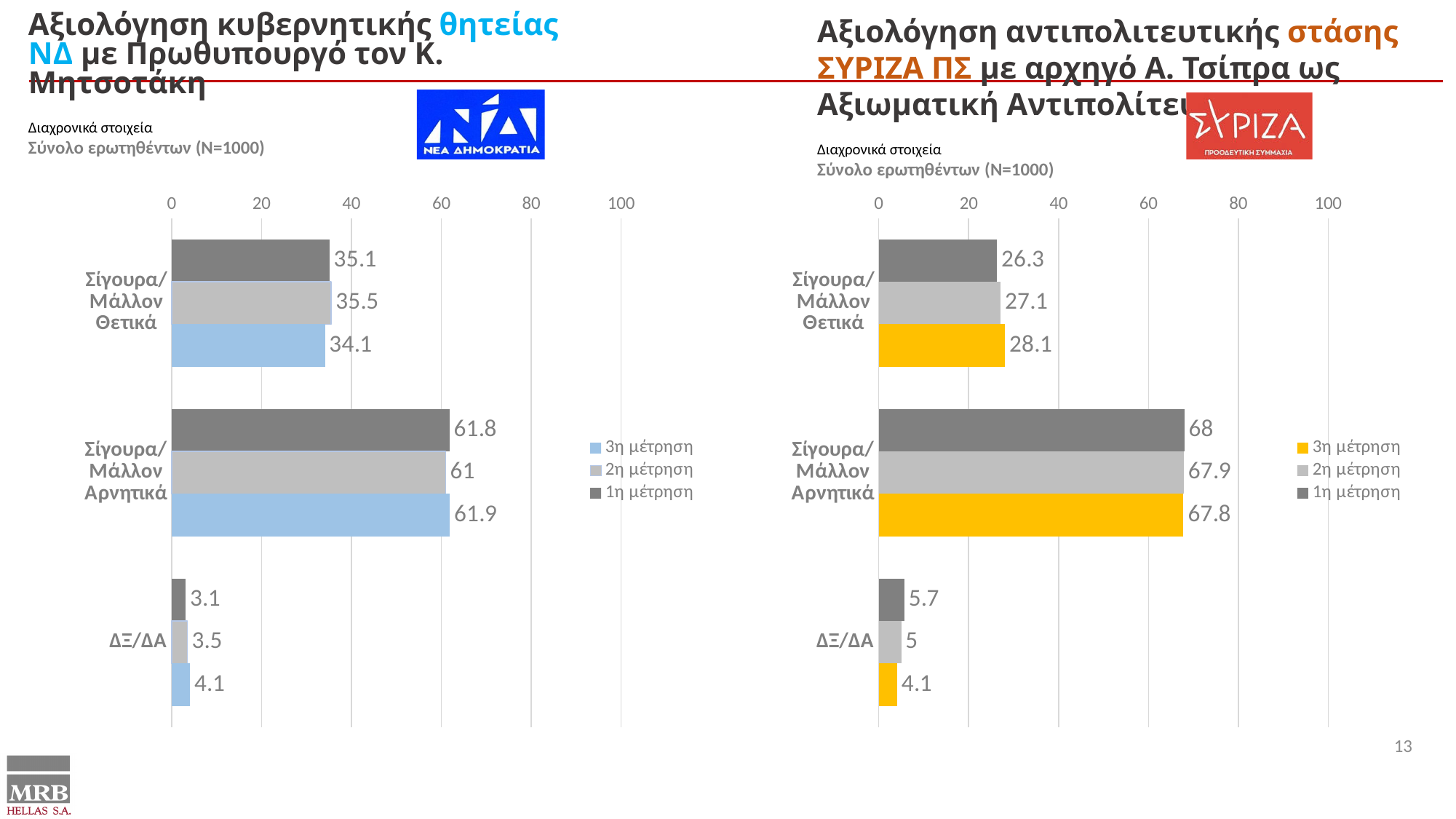
In the right chart (ΣΥΡΙΖΑ ΠΣ), which category has the lowest value in the 3η μέτρηση series? ΔΞ/ΔΑ How many categories are shown on the y axis of the right chart (ΣΥΡΙΖΑ ΠΣ)? 3 In the right chart (ΣΥΡΙΖΑ ΠΣ), what is the value for ΔΞ/ΔΑ in the 2η μέτρηση series? 5 In the left chart (ΝΔ), which category has the highest value in the 1η μέτρηση series? Σίγουρα/Μάλλον Αρνητικά In the right chart (ΣΥΡΙΖΑ ΠΣ), what is the value for Σίγουρα/Μάλλον Αρνητικά in the 1η μέτρηση series? 68 In the left chart (ΝΔ), is the 2η μέτρηση value for Σίγουρα/Μάλλον Αρνητικά greater or less than 60? greater In the left chart (ΝΔ), what is the difference between the 3η μέτρηση and 1η μέτρηση values for ΔΞ/ΔΑ? 1 In the right chart (ΣΥΡΙΖΑ ΠΣ), what is the difference between the 3η μέτρηση and 1η μέτρηση values for Σίγουρα/Μάλλον Θετικά? 1.8 In the left chart (ΝΔ), what is the value for Σίγουρα/Μάλλον Θετικά in the 3η μέτρηση series? 34.1 Which is larger: the 3η μέτρηση value for Σίγουρα/Μάλλον Θετικά in the left chart (ΝΔ) or in the right chart (ΣΥΡΙΖΑ ΠΣ)? Left chart (ΝΔ), 34.1 What type of chart is used on the right side of the slide (ΣΥΡΙΖΑ ΠΣ)? Bar chart How many series does the legend of the left chart (ΝΔ) list? 3